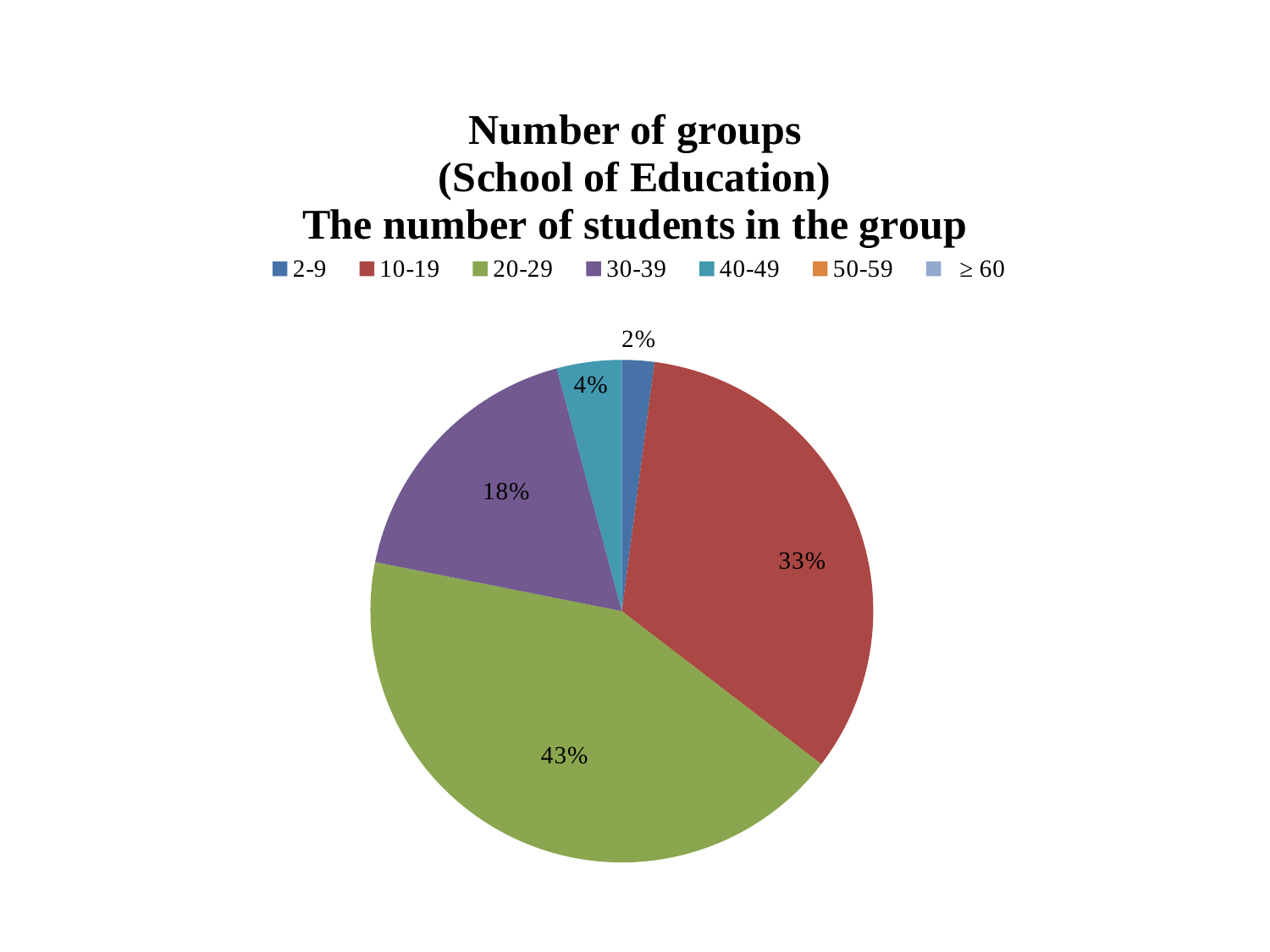
What colour is the 20-29 slice? green Which category with a visible slice has the smallest share of the pie? 2-9 How many categories does the legend list? 7 Which category has the largest slice of the pie? 20-29 What share of the pie does the 30-39 category have? 18% What share of the pie does the 40-49 category have? 4% Which slice is larger, 30-39 or 40-49? 30-39 What share of the pie does the 20-29 category have? 43% What is the difference in percentage points between the 20-29 and 10-19 slices? 10 What kind of chart is shown on the slide? pie chart